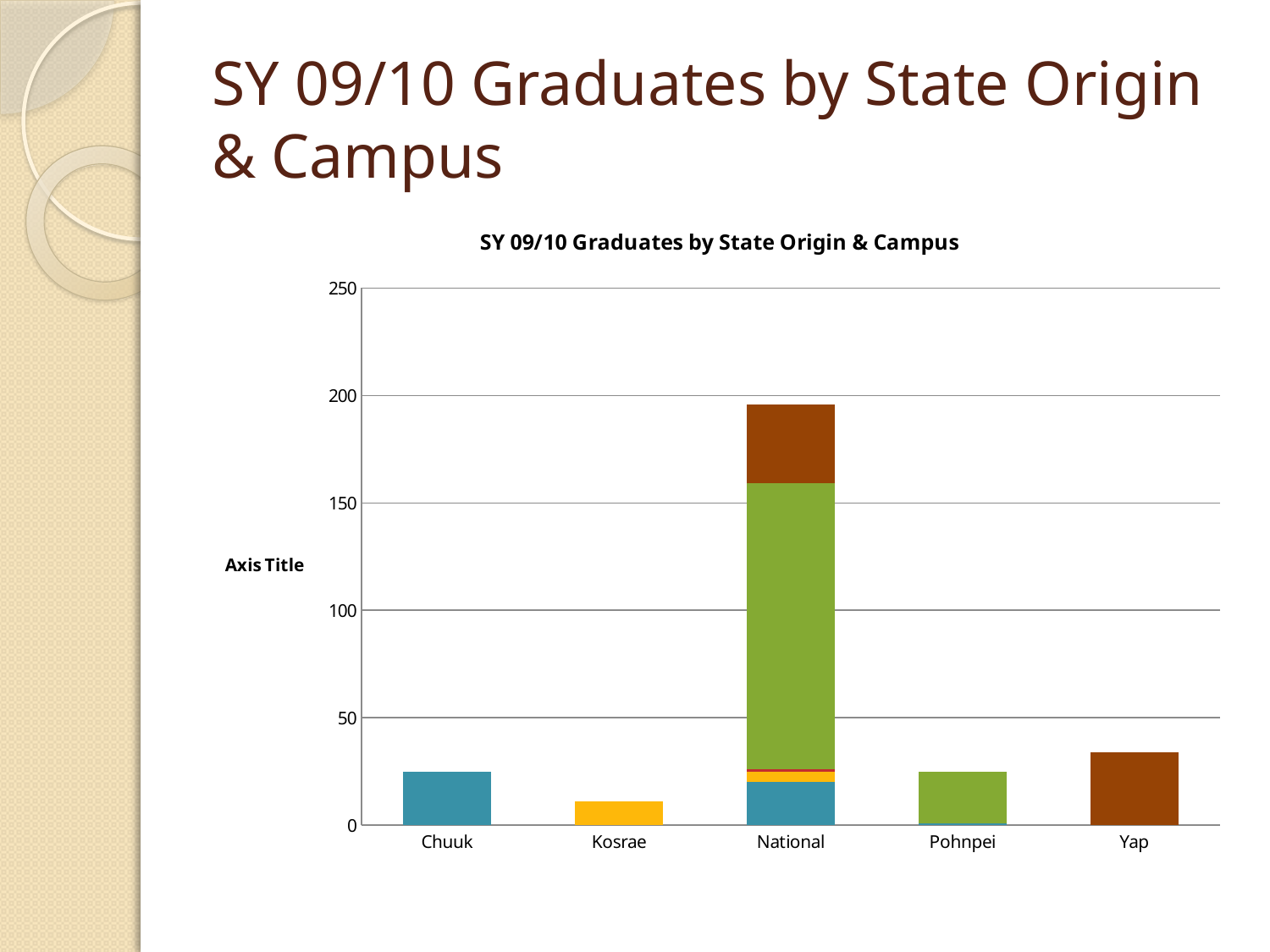
Is the total value for National greater or less than 200? less Which category has the shortest bar? Kosrae Is the total value for National greater or less than 150? greater Is the value for Yap greater or less than 50? less What is the label shown on the vertical axis? Axis Title What kind of chart is shown on the slide? stacked bar chart Which bar is taller, Yap or Chuuk? Yap How many categories are shown along the x axis? 5 Which category has the tallest bar? National Which bar is taller, Yap or Kosrae? Yap What is the title of the chart? SY 09/10 Graduates by State Origin & Campus